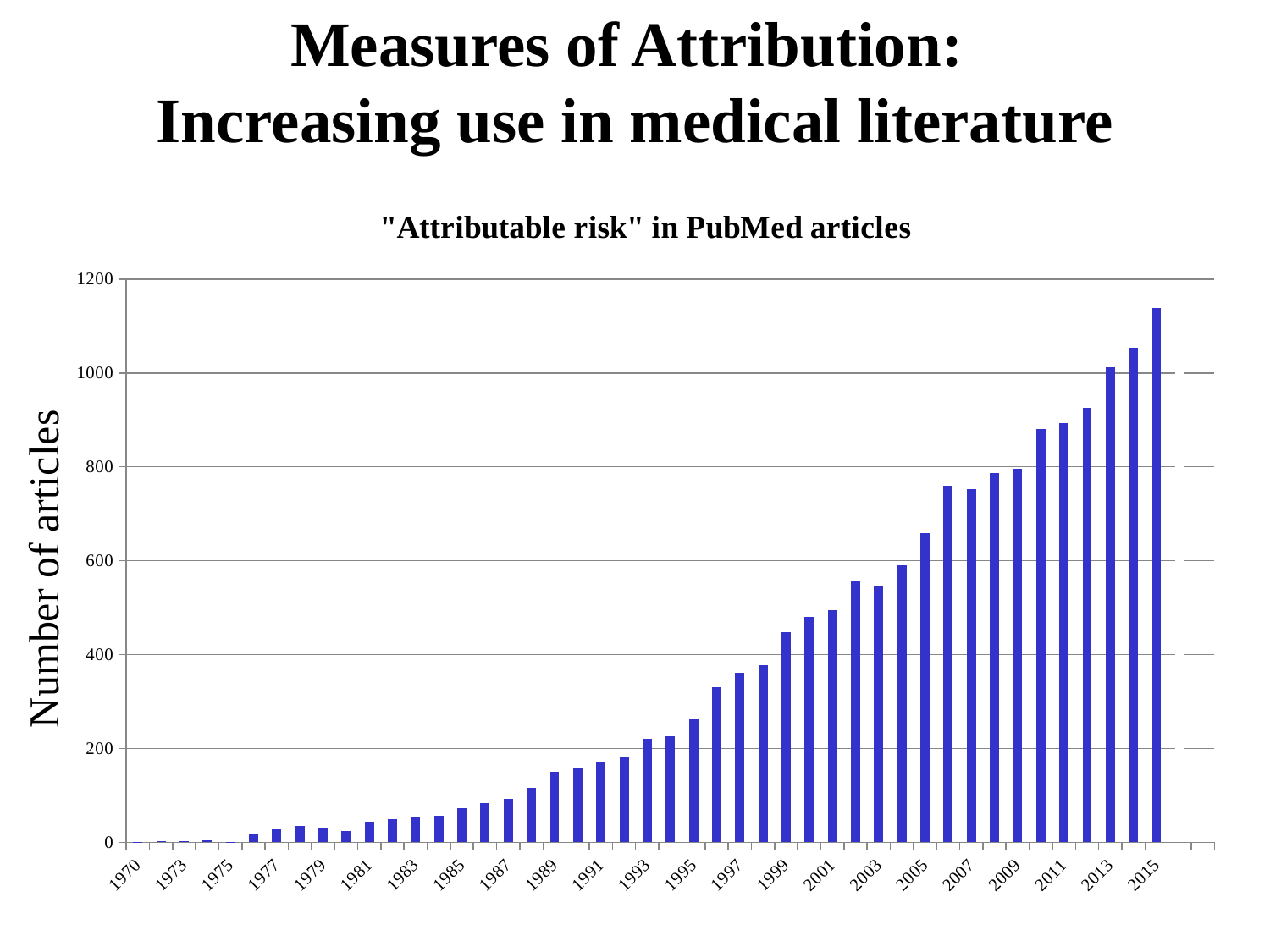
Is the value for 2011 greater or less than 1000? less Is the value for 2015 greater or less than 1000? greater What is the title of the chart? "Attributable risk" in PubMed articles Which year has the highest number of articles? 2015 Do the values generally rise or fall from 1970 to 2015? rise Is the value for 2003 greater or less than 600? less What is the label on the vertical axis of the chart? Number of articles Which year has more articles, 2005 or 2003? 2005 What kind of chart is shown on the slide? bar chart